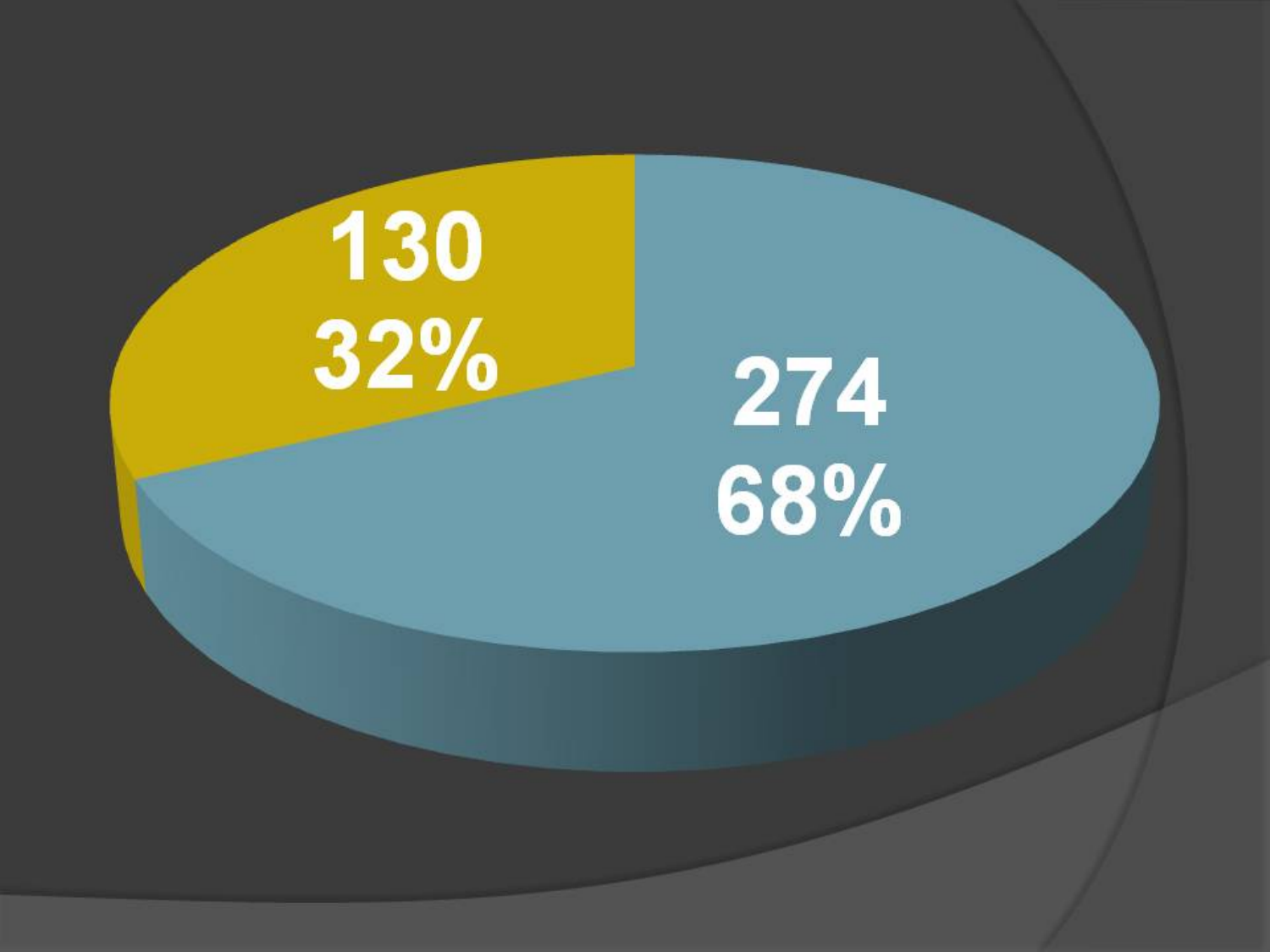
Which slice has the larger value, the blue slice or the yellow slice? the blue slice What value is printed on the yellow slice of the pie chart? 130 What share of the pie does the yellow slice represent? 32% What value is printed on the blue slice of the pie chart? 274 What is the total of the two values shown on the pie chart? 404 What kind of chart is shown on the slide? pie chart What is the difference between the values of the blue slice and the yellow slice? 144 What colour is the slice labelled 32%? yellow What share of the pie does the blue slice represent? 68% How many slices does the pie chart have? 2 Which slice of the pie chart is the smallest? the yellow slice Which slice of the pie chart is the largest? the blue slice